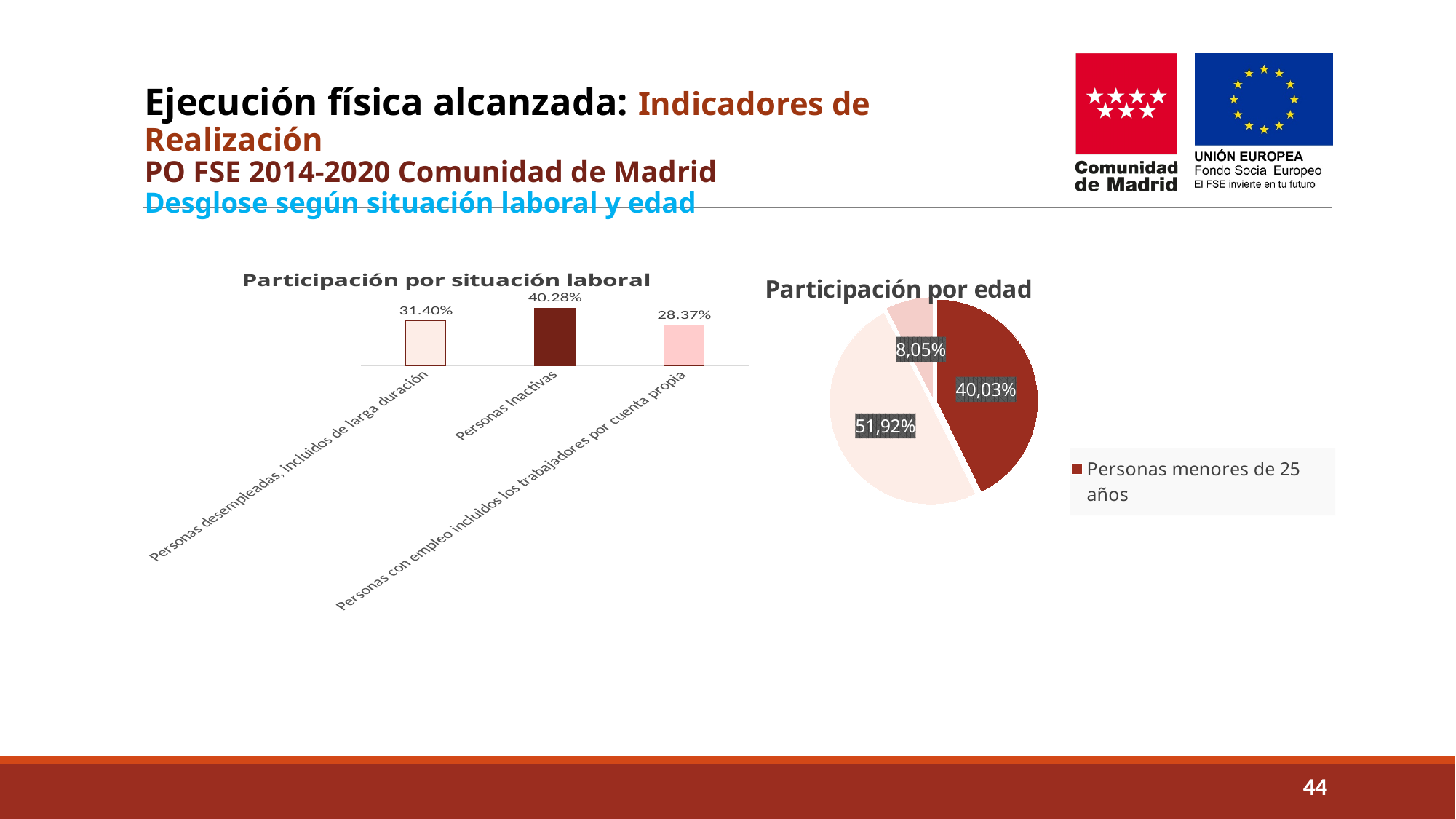
In the 'Participación por situación laboral' chart, what is the value for Personas desempleadas, incluidos de larga duración? 31.40% In the 'Participación por situación laboral' chart, which is larger: the value for Personas desempleadas, incluidos de larga duración or for Personas con empleo incluidos los trabajadores por cuenta propia? Personas desempleadas, incluidos de larga duración What kind of chart is 'Participación por situación laboral'? Bar chart What kind of chart is 'Participación por edad'? Pie chart In the 'Participación por situación laboral' chart, what is the value for Personas Inactivas? 40.28% In the 'Participación por situación laboral' chart, which category has the lowest value? Personas con empleo incluidos los trabajadores por cuenta propia In the 'Participación por situación laboral' chart, which category has the highest value? Personas Inactivas In the 'Participación por situación laboral' chart, what is the difference between the values for Personas Inactivas and Personas desempleadas, incluidos de larga duración? 8.88% In the 'Participación por edad' chart, what is the value of the largest slice? 51,92% In the 'Participación por edad' chart, what share of the pie is Personas menores de 25 años? 40,03% How many categories are shown in the 'Participación por situación laboral' chart? 3 In the 'Participación por situación laboral' chart, what is the value for Personas con empleo incluidos los trabajadores por cuenta propia? 28.37%